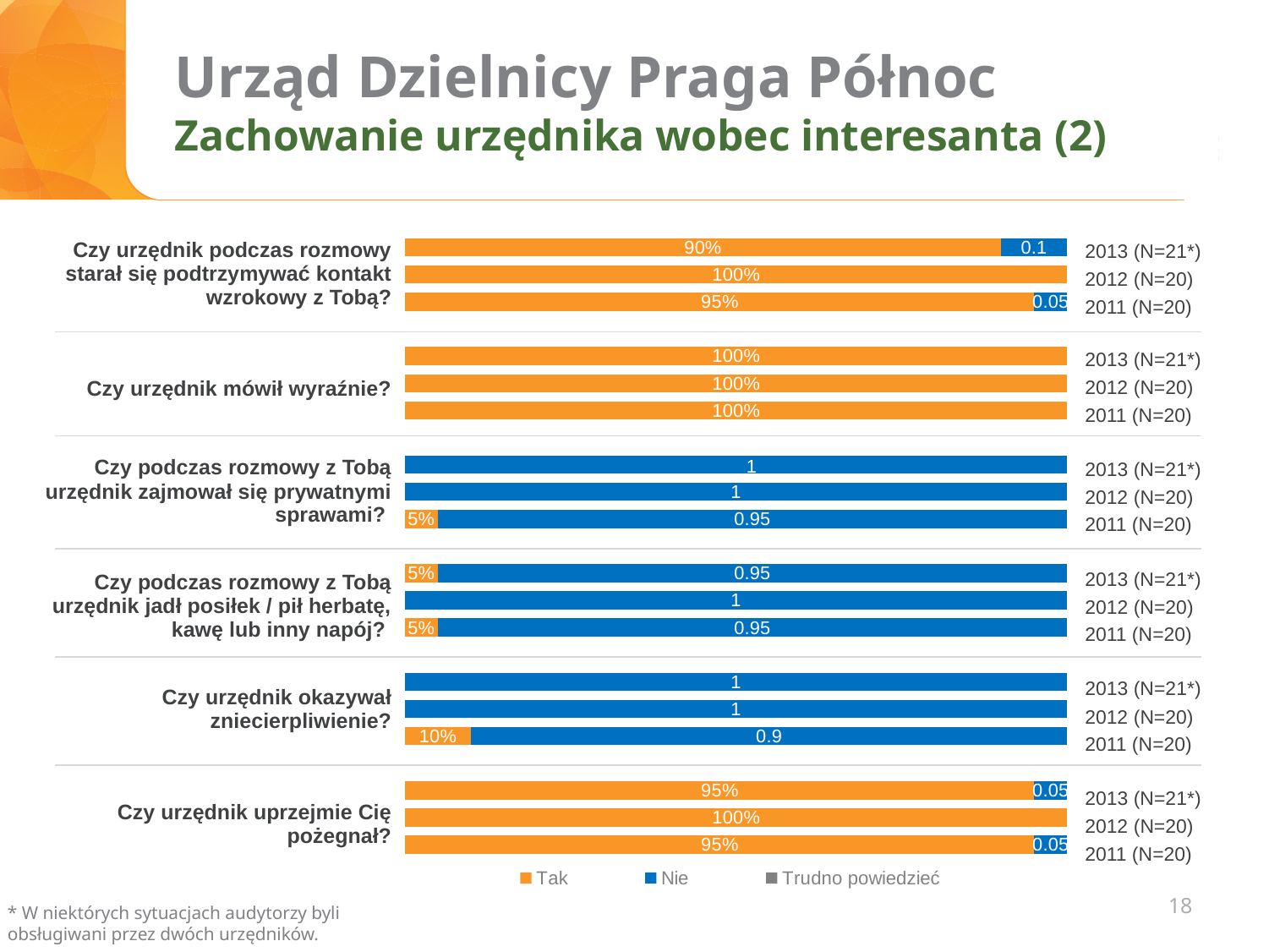
What is the "Nie" value for "Czy urzędnik podczas rozmowy starał się podtrzymywać kontakt wzrokowy z Tobą?" in 2013 (N=21*)? 0.1 What is the "Tak" value for "Czy podczas rozmowy z Tobą urzędnik jadł posiłek / pił herbatę, kawę lub inny napój?" in 2013 (N=21*)? 5% How many series does the legend list? 3 What is the "Nie" value for "Czy urzędnik uprzejmie Cię pożegnał?" in 2013 (N=21*)? 0.05 What is the "Tak" value for "Czy urzędnik mówił wyraźnie?" in 2012 (N=20)? 100% How many questions (categories) are shown in the chart? 6 What kind of chart is shown on the slide? Bar chart What is the "Tak" value for "Czy urzędnik podczas rozmowy starał się podtrzymywać kontakt wzrokowy z Tobą?" in 2013 (N=21*)? 90% Which year has the larger "Tak" value for "Czy urzędnik podczas rozmowy starał się podtrzymywać kontakt wzrokowy z Tobą?": 2012 (N=20) or 2013 (N=21*)? 2012 (N=20) What is the "Nie" value for "Czy urzędnik okazywał zniecierpliwienie?" in 2011 (N=20)? 0.9 What is the "Tak" value for "Czy urzędnik okazywał zniecierpliwienie?" in 2011 (N=20)? 10% What is the "Nie" value for "Czy podczas rozmowy z Tobą urzędnik zajmował się prywatnymi sprawami?" in 2011 (N=20)? 0.95